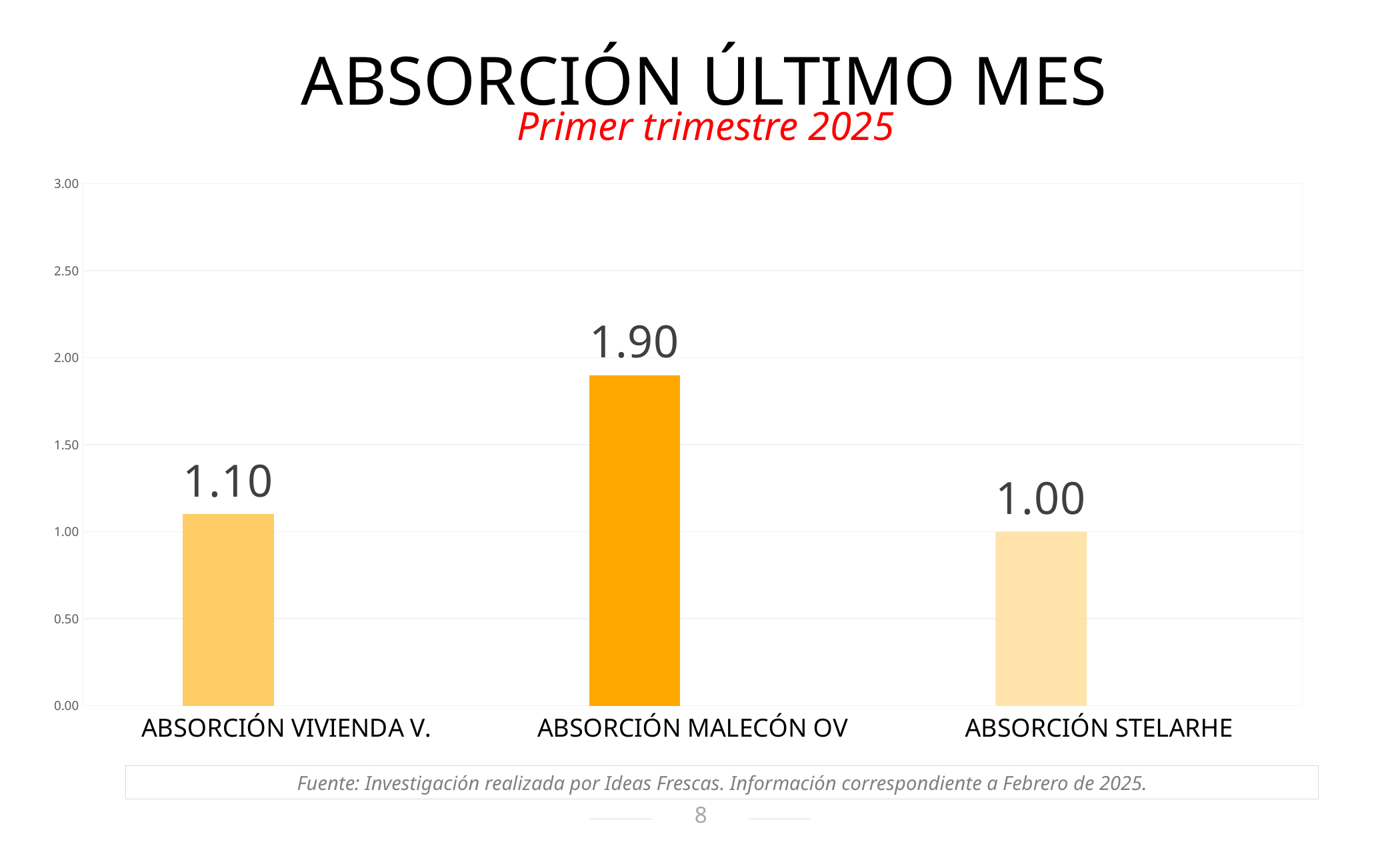
Which category has the highest value? ABSORCIÓN MALECÓN OV Which category has the lowest value? ABSORCIÓN STELARHE Which is larger, the value for ABSORCIÓN MALECÓN OV or the value for ABSORCIÓN STELARHE? ABSORCIÓN MALECÓN OV What is the title of the chart on the slide? ABSORCIÓN ÚLTIMO MES Is the value for ABSORCIÓN MALECÓN OV greater or less than 1.50? greater How many categories are shown in the chart? 3 What is the difference between the values for ABSORCIÓN VIVIENDA V. and ABSORCIÓN STELARHE? 0.10 What is the value for ABSORCIÓN STELARHE? 1.00 What is the value for ABSORCIÓN VIVIENDA V.? 1.10 What is the value for ABSORCIÓN MALECÓN OV? 1.90 What is the difference between the values for ABSORCIÓN MALECÓN OV and ABSORCIÓN VIVIENDA V.? 0.80 What kind of chart is shown on the slide? bar chart